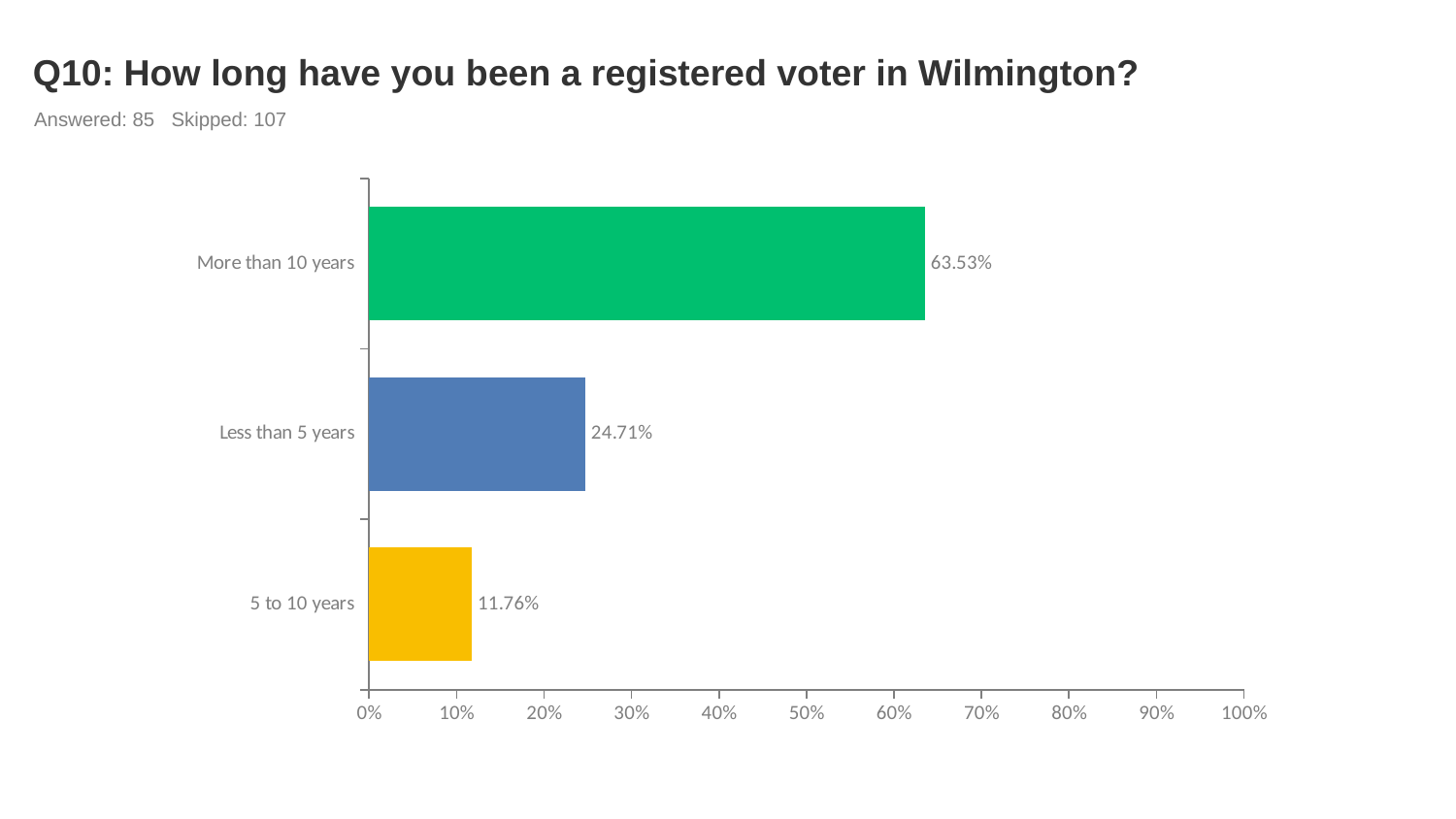
Which category has the highest percentage? More than 10 years What is the value shown for '5 to 10 years'? 11.76% What kind of chart is shown on the slide? Bar chart How many categories are shown in the chart? 3 What colour is the bar for 'More than 10 years'? Green How many respondents answered this question? 85 What is the difference in percentage points between 'More than 10 years' and 'Less than 5 years'? 38.82 Which category has the lowest percentage? 5 to 10 years What is the value shown for 'Less than 5 years'? 24.71% Is the value for 'More than 10 years' greater or less than 60%? greater Which is larger: the value for 'Less than 5 years' or the value for '5 to 10 years'? Less than 5 years What percentage of respondents have been registered voters in Wilmington for more than 10 years? 63.53%